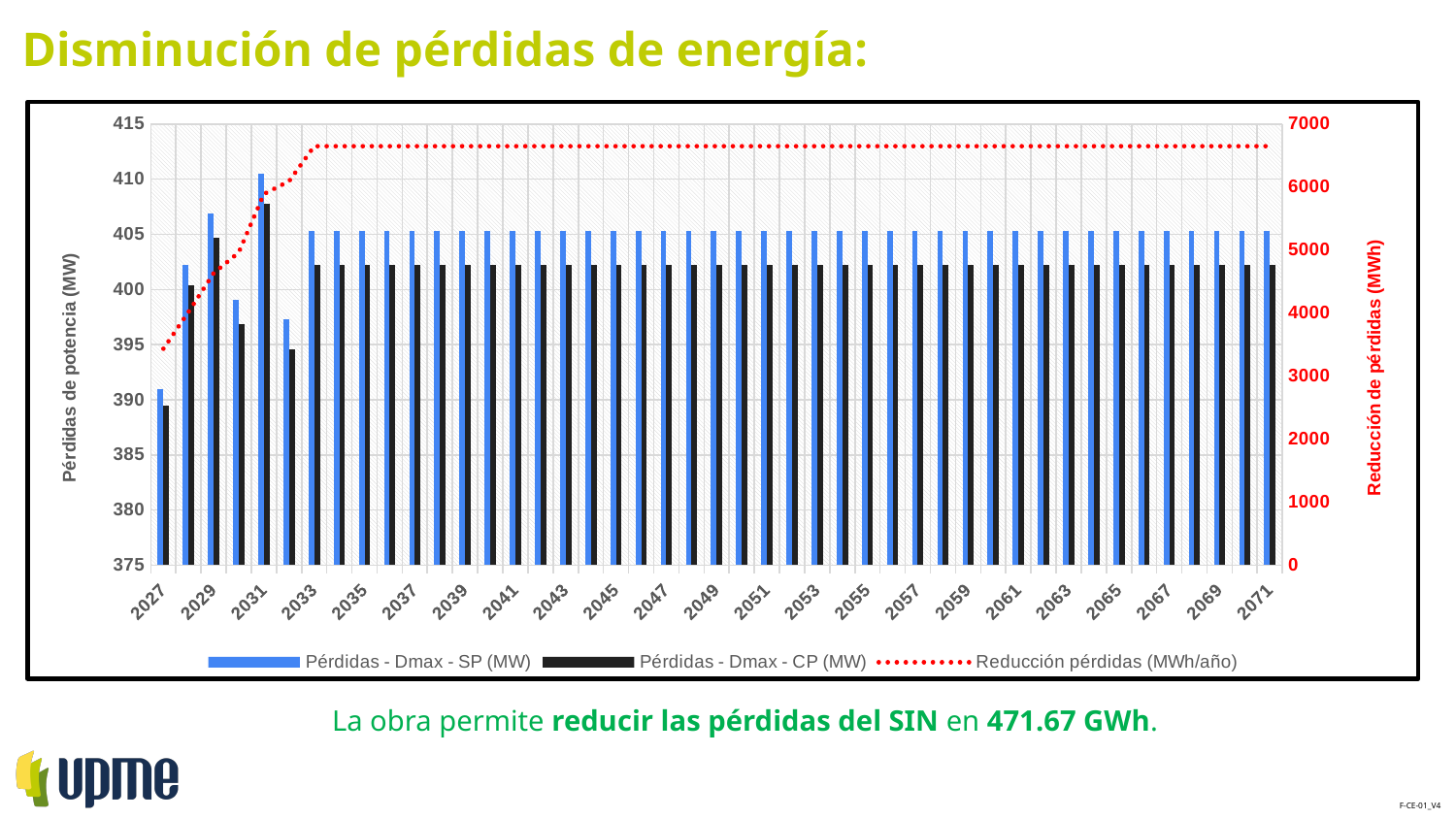
What type of chart is shown on the slide? A combined bar and line chart Is the value of Reducción pérdidas (MWh/año) in 2050 greater or less than 6000? greater Is the value of Pérdidas - Dmax - SP (MW) in 2031 greater or less than 405? greater In which year is the value of Pérdidas - Dmax - CP (MW) lowest? 2027 Does the Reducción pérdidas (MWh/año) line rise or fall between 2027 and 2033? rise Is the value of Pérdidas - Dmax - CP (MW) in 2027 greater or less than 395? less What is the title of the slide containing the chart? Disminución de pérdidas de energía: What is the label of the right-hand vertical axis? Reducción de pérdidas (MWh) How many series does the legend list? 3 In 2031, which is larger: Pérdidas - Dmax - SP (MW) or Pérdidas - Dmax - CP (MW)? Pérdidas - Dmax - SP (MW) In which year is the value of Pérdidas - Dmax - SP (MW) highest? 2031